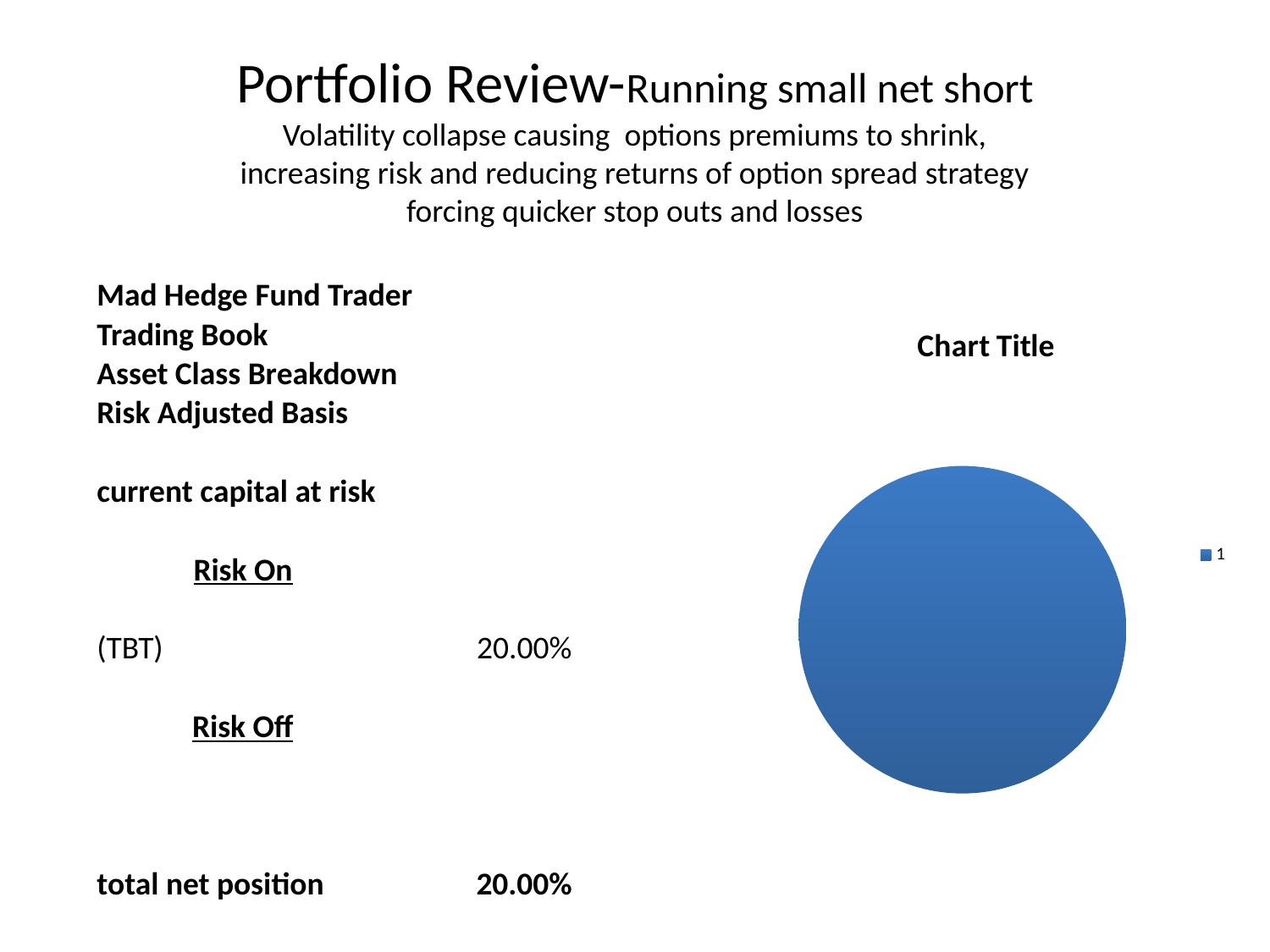
What is the title of the chart on the slide? Chart Title How many entries does the chart's legend list? 1 What label does the legend show for the single slice of the pie chart? 1 What kind of chart is shown on the slide? pie chart What share of the pie does the single slice labelled 1 take up? 100% How many slices does the pie chart have? 1